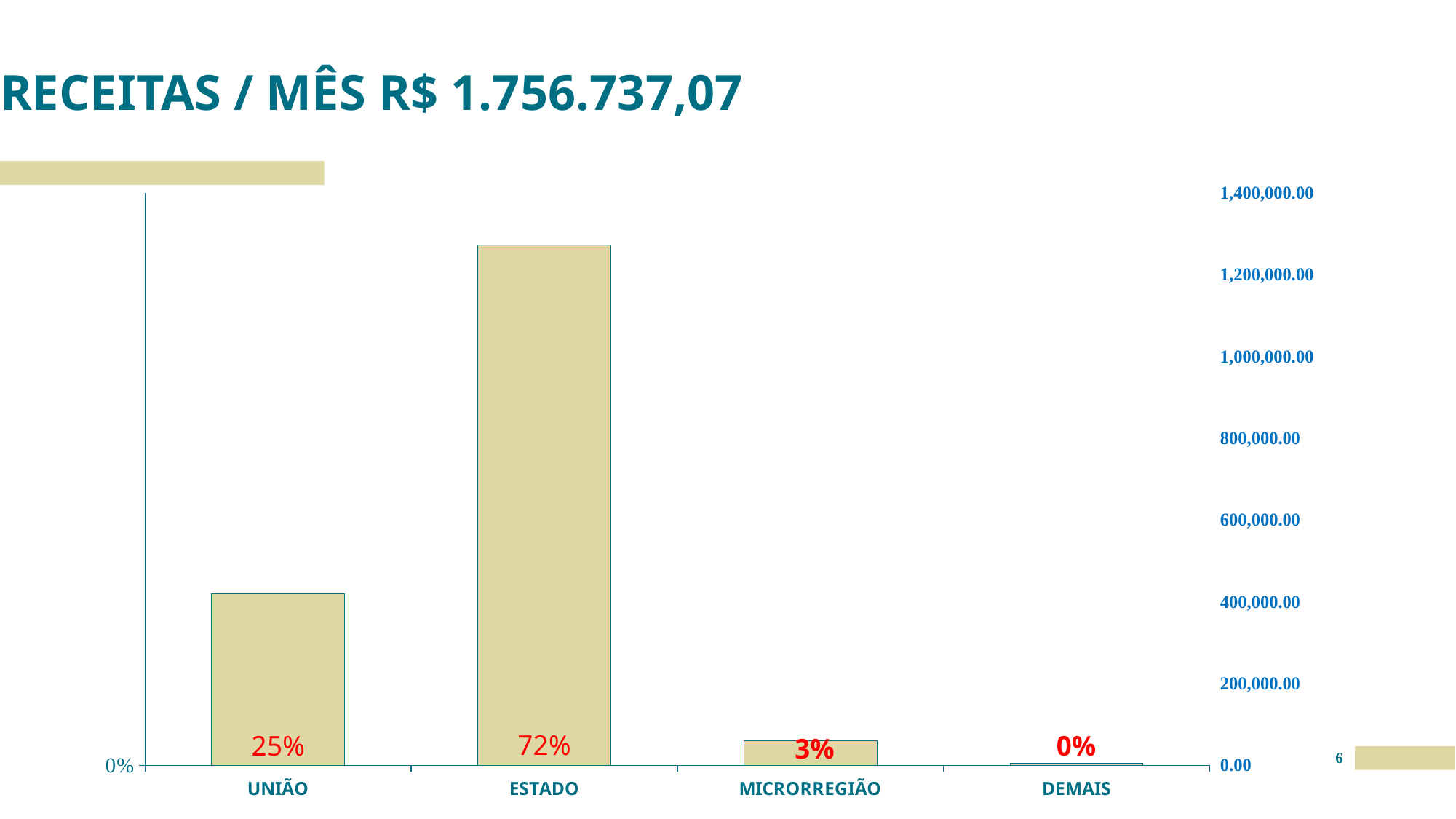
What percentage label is shown on the bar for MICRORREGIÃO? 3% What is the title of the slide? RECEITAS / MÊS R$ 1.756.737,07 What kind of chart is shown on the slide? bar chart Is the value for ESTADO greater or less than 1,000,000.00? greater Which category has the highest bar? ESTADO Which category has the lowest bar? DEMAIS Is the value for UNIÃO greater or less than 600,000.00? less What percentage label is shown on the bar for UNIÃO? 25% What percentage label is shown on the bar for DEMAIS? 0% What percentage label is shown on the bar for ESTADO? 72% Which is larger, the bar for UNIÃO or the bar for MICRORREGIÃO? UNIÃO How many categories are shown on the x axis of the chart? 4